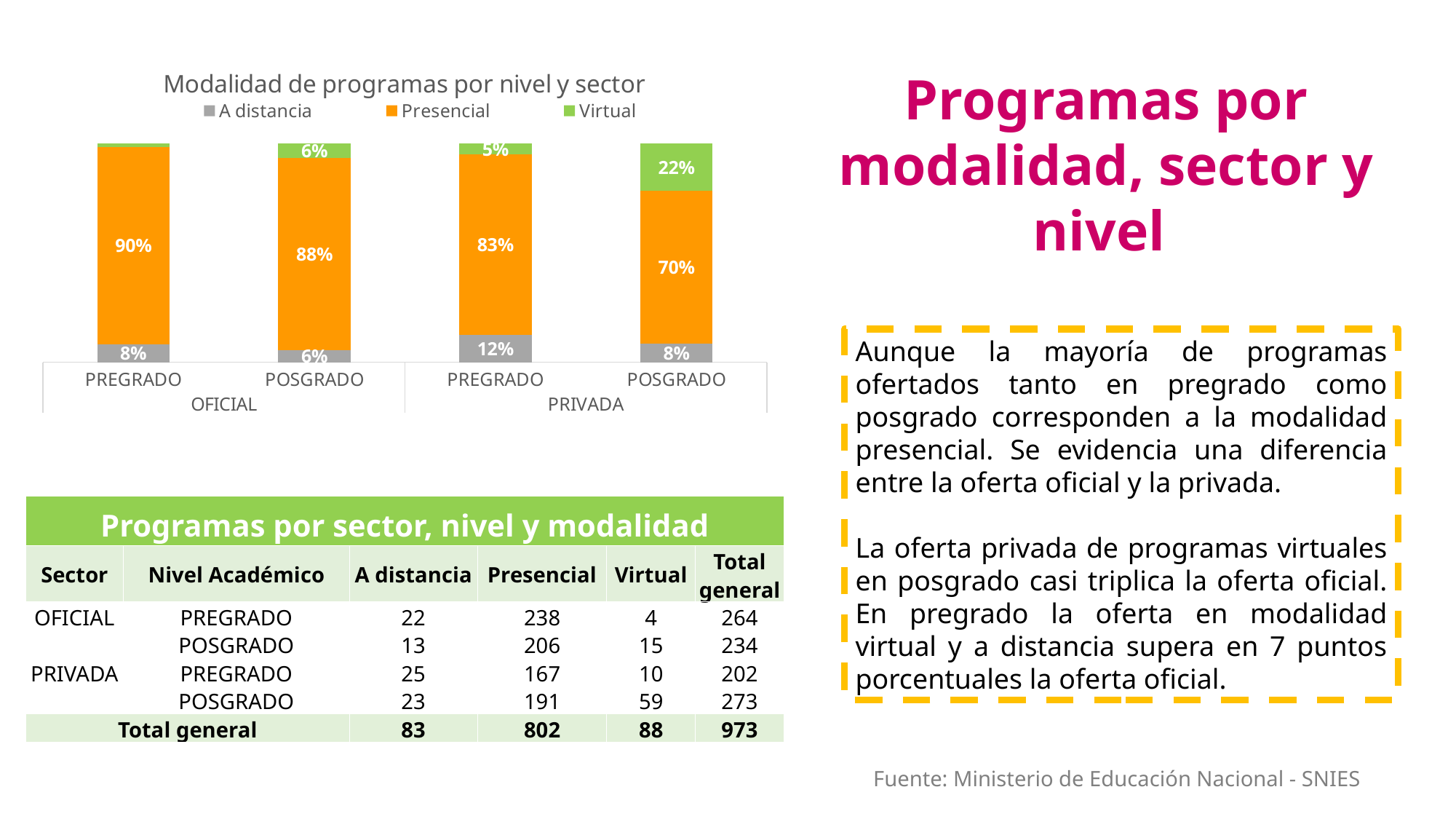
What kind of chart is shown on the slide? Stacked bar chart What is the title of the chart? Modalidad de programas por nivel y sector What is the difference between the Presencial share for OFICIAL PREGRADO and PRIVADA POSGRADO? 20 percentage points Which bar has the highest Virtual share? PRIVADA POSGRADO What is the A distancia share for PREGRADO in the PRIVADA sector? 12% Which is larger, the A distancia share for PRIVADA PREGRADO or for OFICIAL POSGRADO? PRIVADA PREGRADO How many bars are plotted in the chart? 4 How many series does the chart legend list? 3 What is the Virtual share for POSGRADO in the PRIVADA sector? 22% Which bar has the lowest Presencial share? PRIVADA POSGRADO What is the Presencial share for POSGRADO in the OFICIAL sector? 88% What is the Presencial share for PREGRADO in the OFICIAL sector? 90%